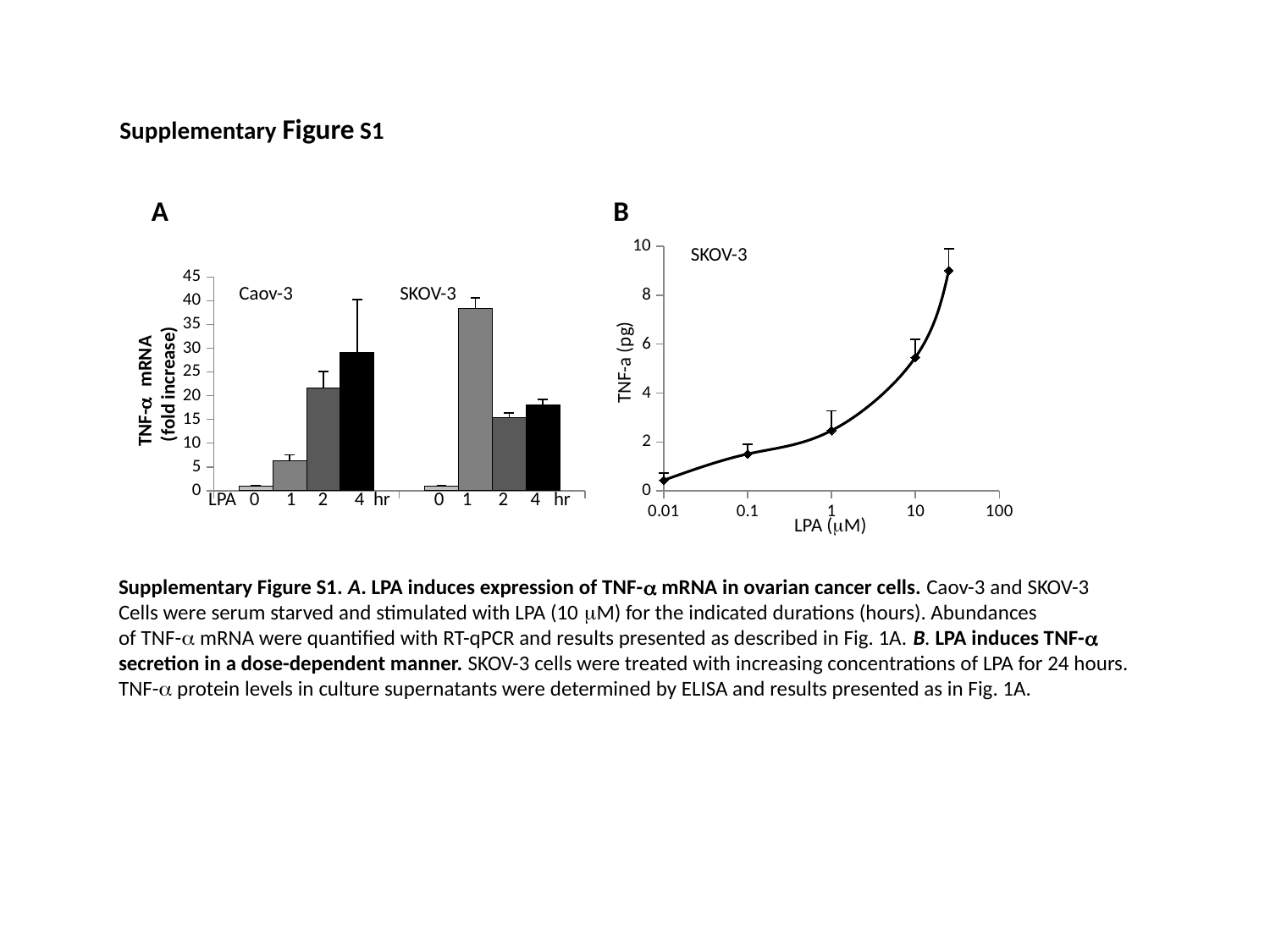
What kind of chart is chart A (the left chart)? bar chart In chart B, is the TNF-a value at 10 µM LPA greater or less than 4? greater In chart B, how many data points are plotted on the curve? 5 In chart A, which is larger at 2 hr: the Caov-3 bar or the SKOV-3 bar? Caov-3 In chart A, at which LPA time point is the Caov-3 TNF-α mRNA fold increase highest? 4 hr In chart A, do the Caov-3 values rise or fall as the LPA treatment time increases from 0 to 4 hr? rise In chart A, is the SKOV-3 value at 2 hr greater or less than 20? less In chart A, is the Caov-3 value at 4 hr greater or less than 25? greater What kind of chart is chart B (the right chart, SKOV-3)? line chart In chart A, at which LPA time point is the SKOV-3 TNF-α mRNA fold increase highest? 1 hr In chart B, does TNF-a (pg) rise or fall as the LPA concentration increases? rise